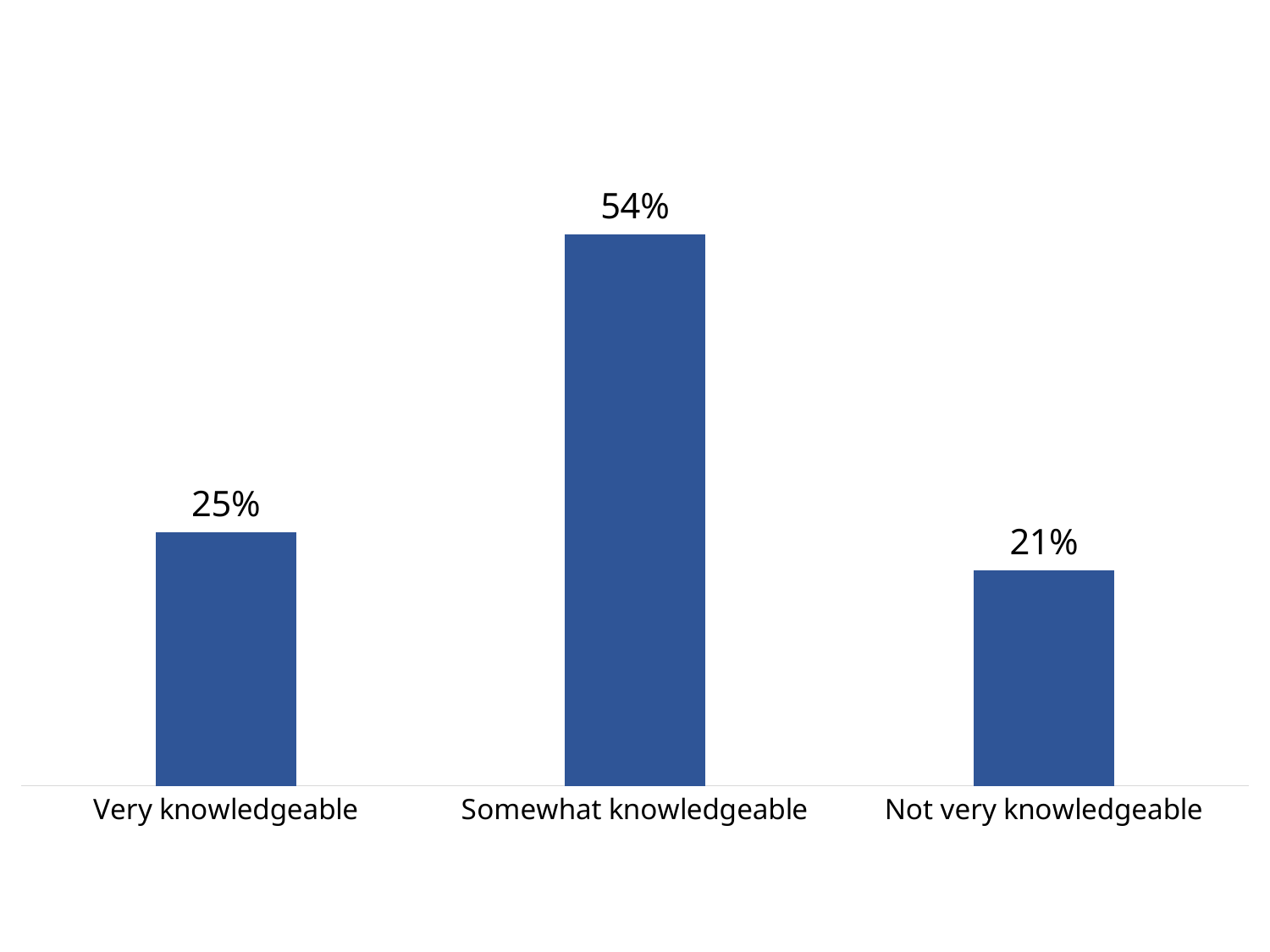
What colour are the bars in the chart? Blue Which is larger, the value for Somewhat knowledgeable or the value for Not very knowledgeable? Somewhat knowledgeable How many categories are shown on the chart? 3 Which is larger, the value for Very knowledgeable or the value for Not very knowledgeable? Very knowledgeable What is the value for Somewhat knowledgeable? 54% Which category has the lowest value? Not very knowledgeable What kind of chart is shown on the slide? Bar chart What is the difference between the values for Somewhat knowledgeable and Very knowledgeable? 29% What is the difference between the values for Very knowledgeable and Not very knowledgeable? 4% Which category has the highest value? Somewhat knowledgeable What is the value for Very knowledgeable? 25% What is the value for Not very knowledgeable? 21%